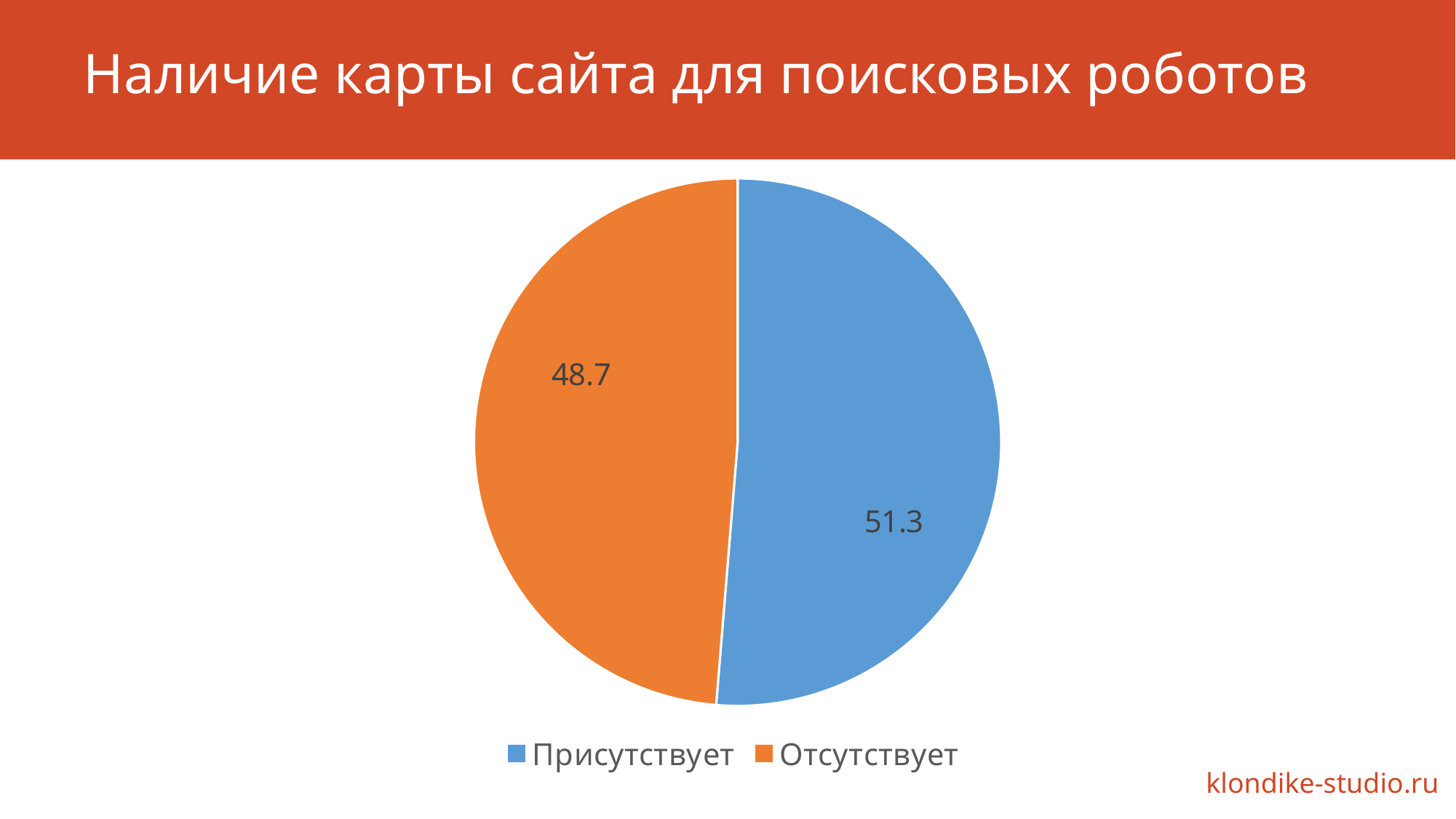
What is the value for Отсутствует? 48.7 What colour is the slice for Отсутствует? orange What kind of chart is shown on the slide? pie chart Which is larger, the value for Присутствует or the value for Отсутствует? Присутствует How many entries does the legend list? 2 What is the total of the two slice values? 100 What is the value for Присутствует? 51.3 Which category has the smallest slice? Отсутствует Which category has the largest slice? Присутствует How many slices does the pie chart have? 2 What is the difference between the values for Присутствует and Отсутствует? 2.6 What is the title of the slide? Наличие карты сайта для поисковых роботов